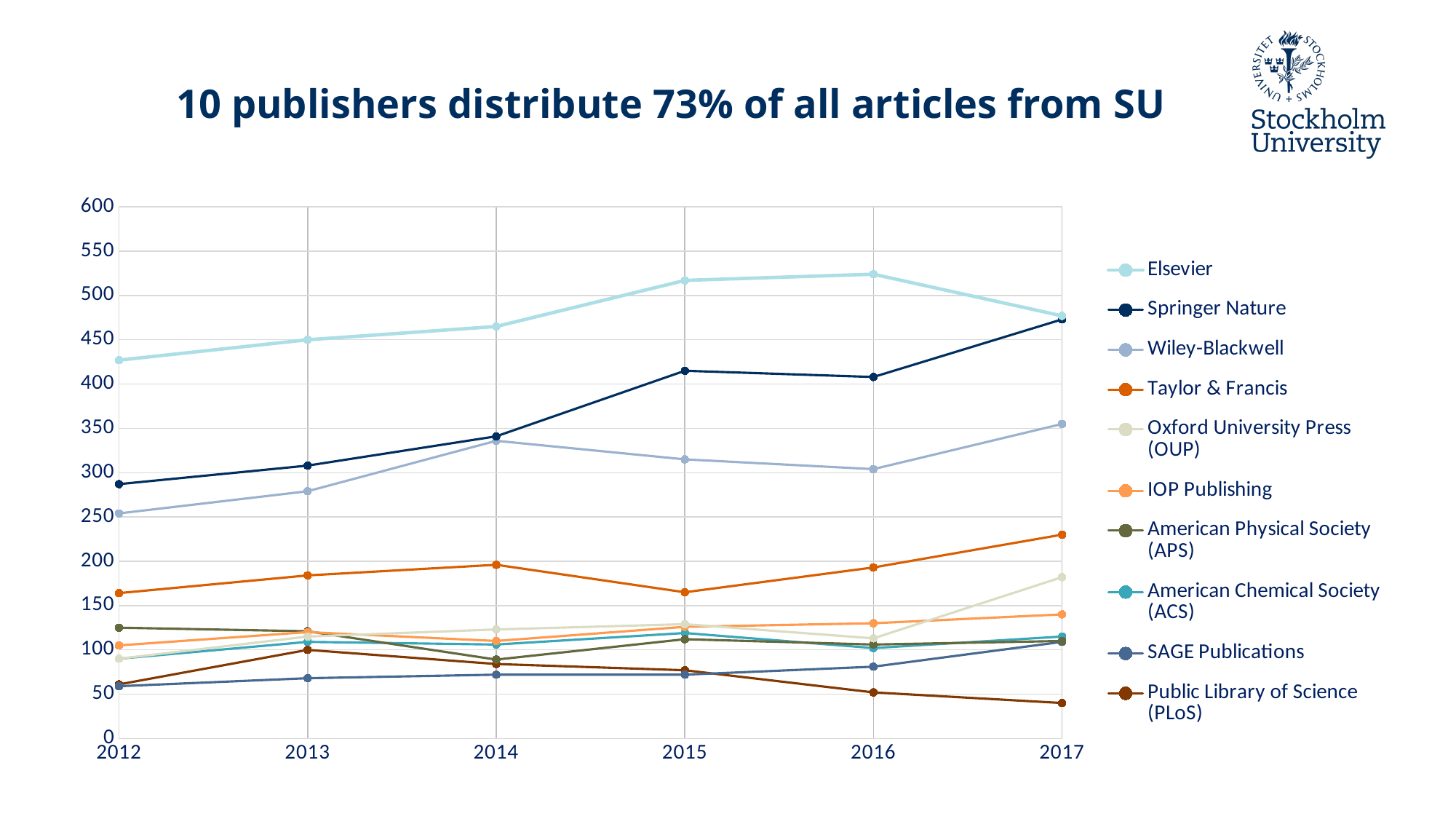
Is the value for Elsevier in 2015 greater or less than 500? greater Does the value for Springer Nature rise or fall overall from 2012 to 2017? rise What type of chart is shown on the slide? line chart How many years are shown along the x axis? 6 Is the value for Taylor & Francis in 2017 greater or less than 200? greater Which publisher has the highest value in 2016? Elsevier In 2017, which is larger: the value for Springer Nature or the value for Wiley-Blackwell? Springer Nature Is the value for Public Library of Science (PLoS) in 2017 greater or less than 50? less Which publisher has the lowest value in 2017? Public Library of Science (PLoS) What is the title of the slide? 10 publishers distribute 73% of all articles from SU How many publishers (series) does the legend list? 10